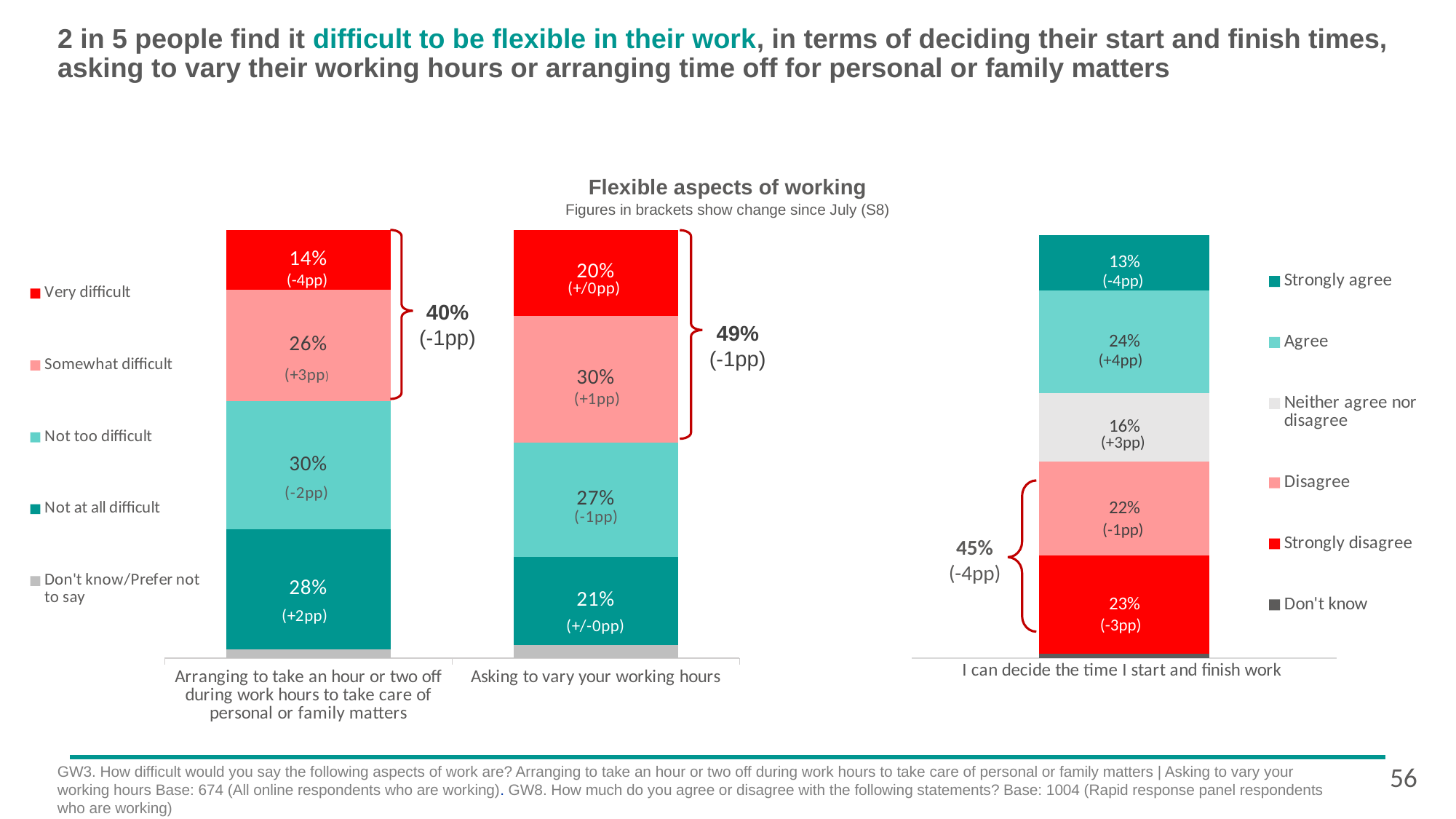
What kind of chart is the 'Flexible aspects of working' chart? Stacked bar chart In the 'Flexible aspects of working' chart, what combined percentage find 'Arranging to take an hour or two off' very or somewhat difficult, as shown by the bracket? 40% How many series does the legend of the 'Flexible aspects of working' chart list? 5 In the 'I can decide the time I start and finish work' chart, what percentage strongly disagree? 23% In the 'Flexible aspects of working' chart, what is the difference in the 'Somewhat difficult' share between 'Asking to vary your working hours' and 'Arranging to take an hour or two off'? 4 percentage points In the 'I can decide the time I start and finish work' chart, which response has the largest share? Agree In the 'Flexible aspects of working' chart, what percentage find 'Arranging to take an hour or two off during work hours to take care of personal or family matters' not at all difficult? 28% How many series does the legend of the 'I can decide the time I start and finish work' chart list? 6 In the 'Flexible aspects of working' chart, what percentage find 'Asking to vary your working hours' very difficult? 20% In the 'Flexible aspects of working' chart, which category has the larger 'Very difficult' share? Asking to vary your working hours How many categories are shown on the x axis of the 'Flexible aspects of working' chart? 2 According to the subtitle of the 'Flexible aspects of working' chart, what do the figures in brackets show? Change since July (S8)